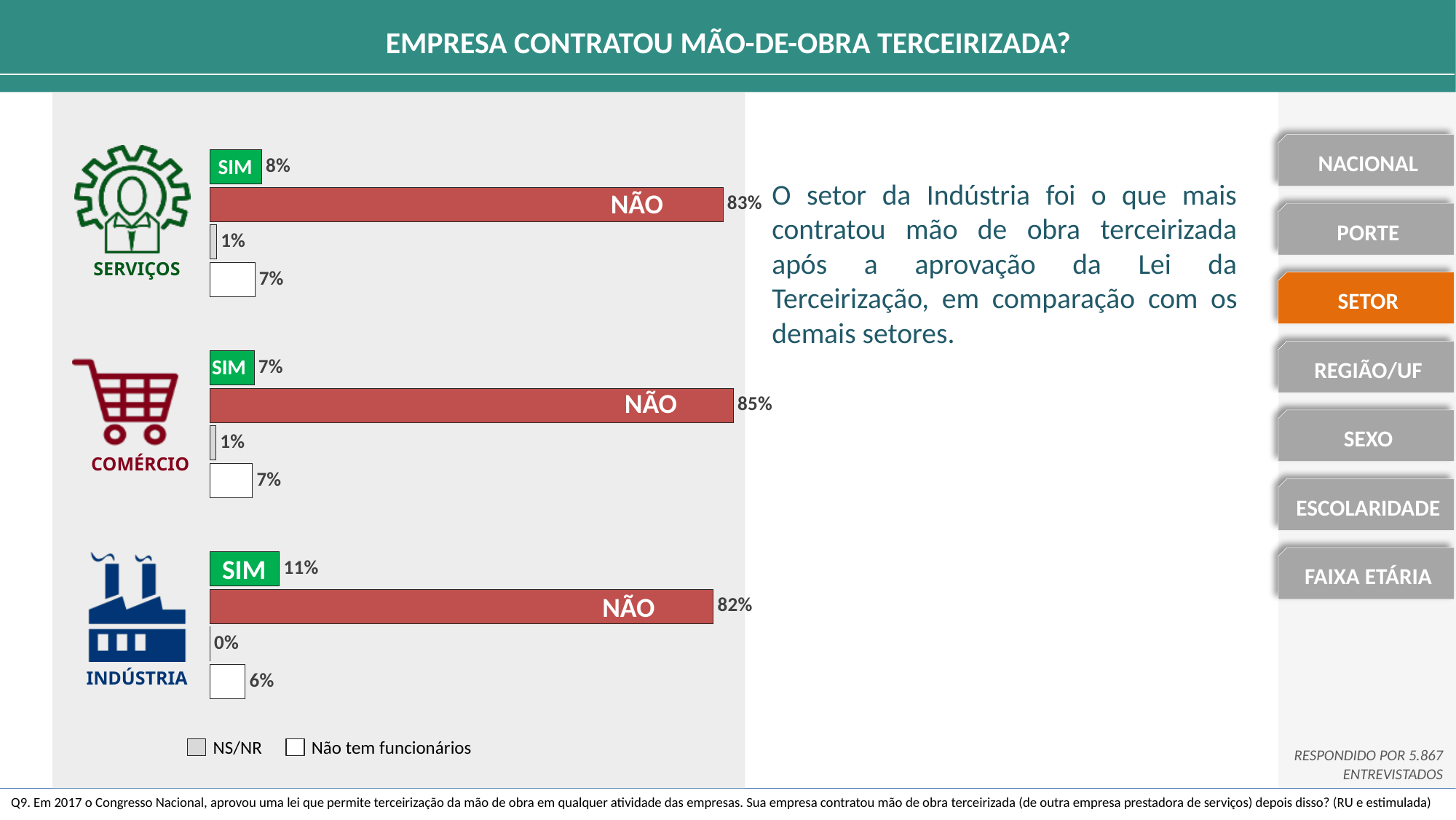
Across the three sector charts, which sector has the lowest NÃO percentage? INDÚSTRIA What type of chart is used to show the responses for each sector? Bar chart In the SERVIÇOS chart, what percentage answered SIM? 8% In the COMÉRCIO chart, what percentage answered NÃO? 85% In the COMÉRCIO chart, what is the value for NS/NR? 1% How many response categories are shown for each sector chart? 4 What colour are the NÃO bars in the charts? Red Which is larger: the SIM percentage for SERVIÇOS or the SIM percentage for COMÉRCIO? SERVIÇOS In the SERVIÇOS chart, what is the difference between the NÃO and SIM percentages? 75% In the INDÚSTRIA chart, what is the value for 'Não tem funcionários'? 6% In the INDÚSTRIA chart, what percentage answered SIM? 11% Across the three sector charts, which sector has the highest SIM percentage? INDÚSTRIA